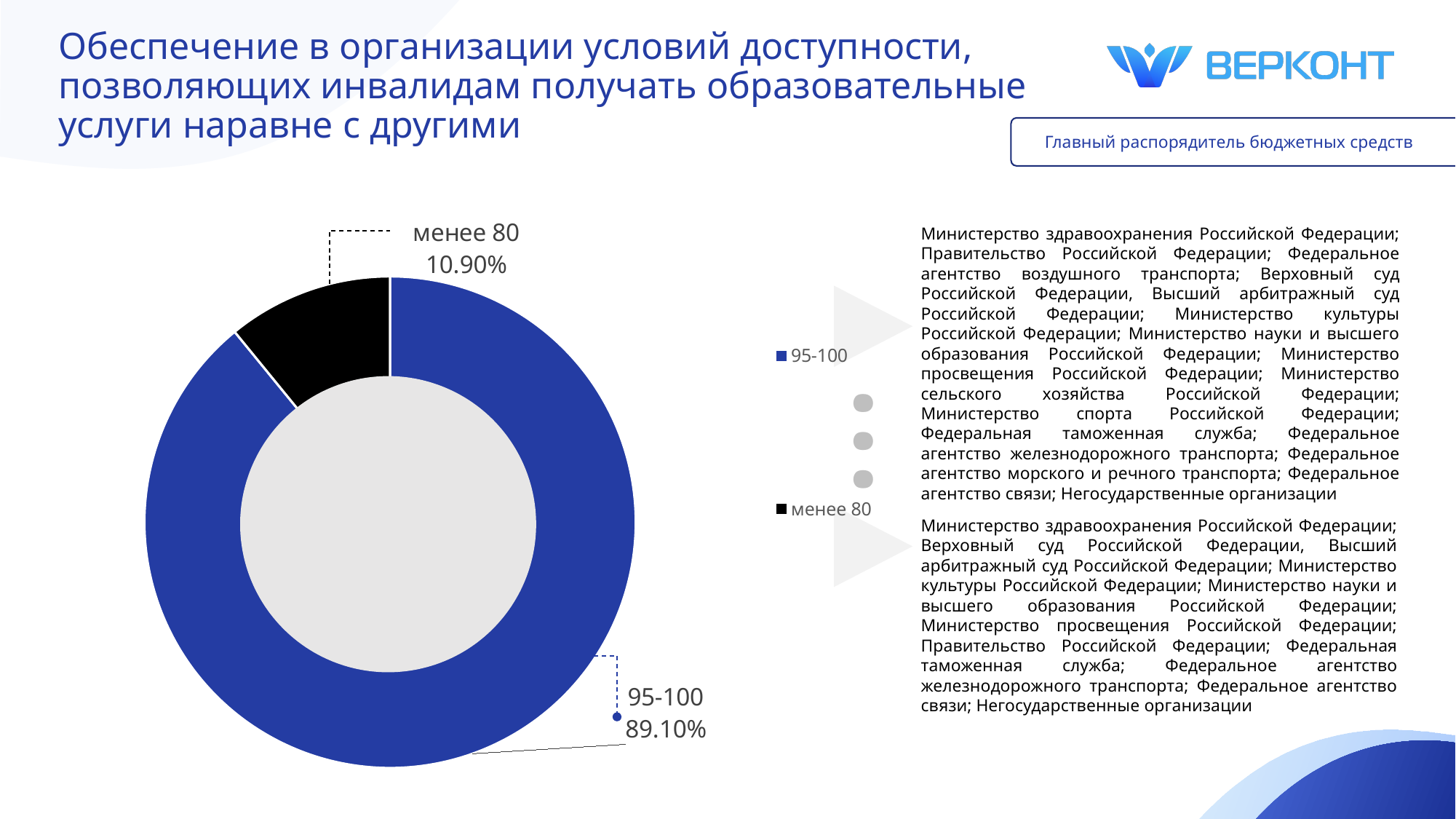
Which category has the largest share of the doughnut? 95-100 What is the total of the two shares shown in the doughnut chart? 100.00% What colour is the "95-100" segment? Blue What is the value for the "менее 80" category? 10.90% How many categories are shown in the doughnut chart? 2 What colour is the "менее 80" segment? Black What is the difference between the "95-100" share and the "менее 80" share? 78.20% Which category has the smallest share of the doughnut? менее 80 Which is larger, the share for "95-100" or the share for "менее 80"? 95-100 How many entries does the legend list? 2 What kind of chart is shown on the slide? Doughnut chart What is the value for the "95-100" category? 89.10%